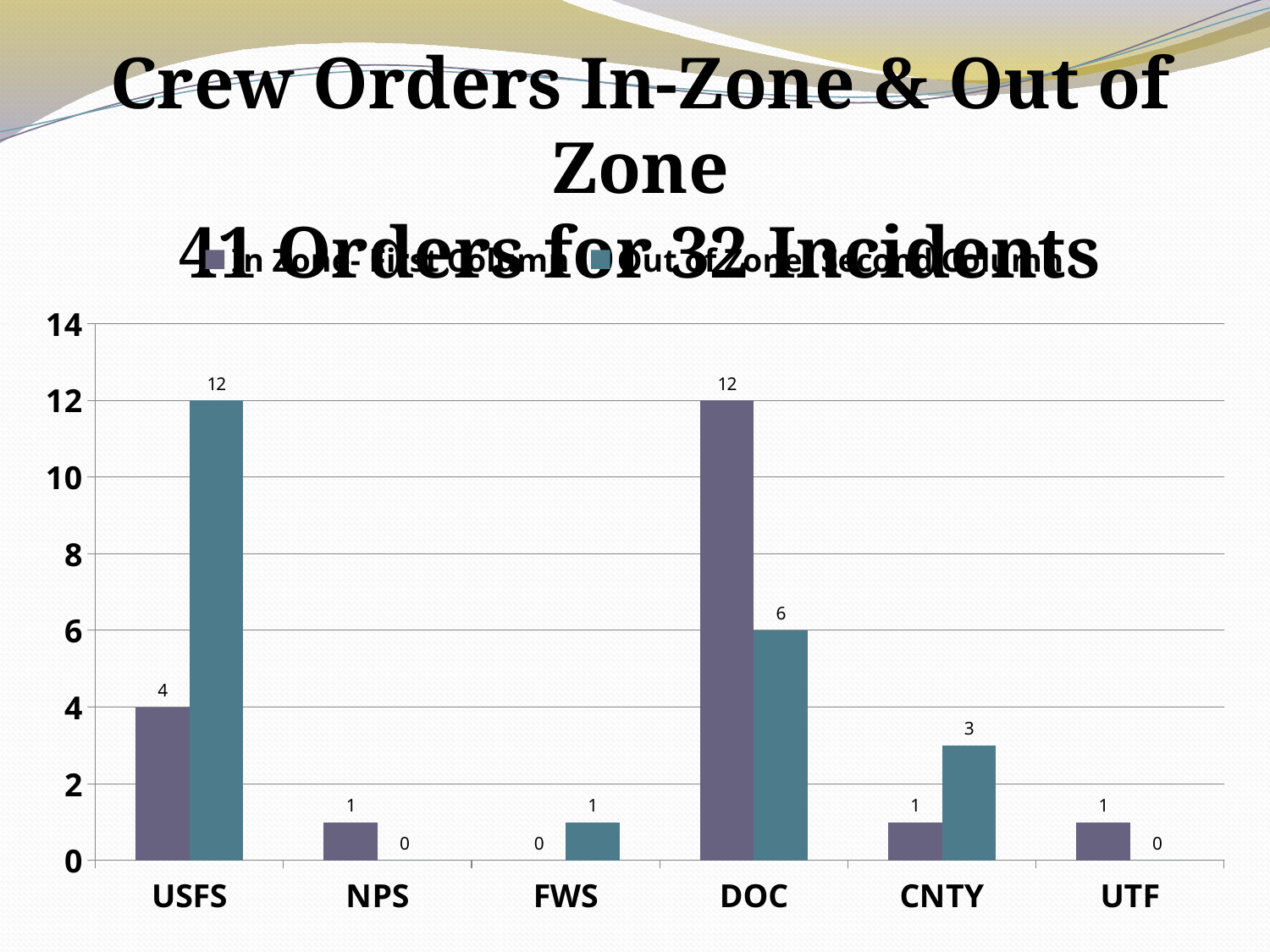
Which category has the highest In Zone value? DOC How many categories are shown on the x axis? 6 Which category has the lowest In Zone value? FWS What is the Out of Zone value for DOC? 6 For CNTY, which is larger: the In Zone value or the Out of Zone value? Out of Zone Which category has the highest Out of Zone value? USFS For DOC, what is the difference between the In Zone and Out of Zone values? 6 What is the Out of Zone value for CNTY? 3 How many series does the legend list? 2 What is the In Zone value for DOC? 12 What is the Out of Zone value for USFS? 12 For USFS, how much larger is the Out of Zone value than the In Zone value? 8